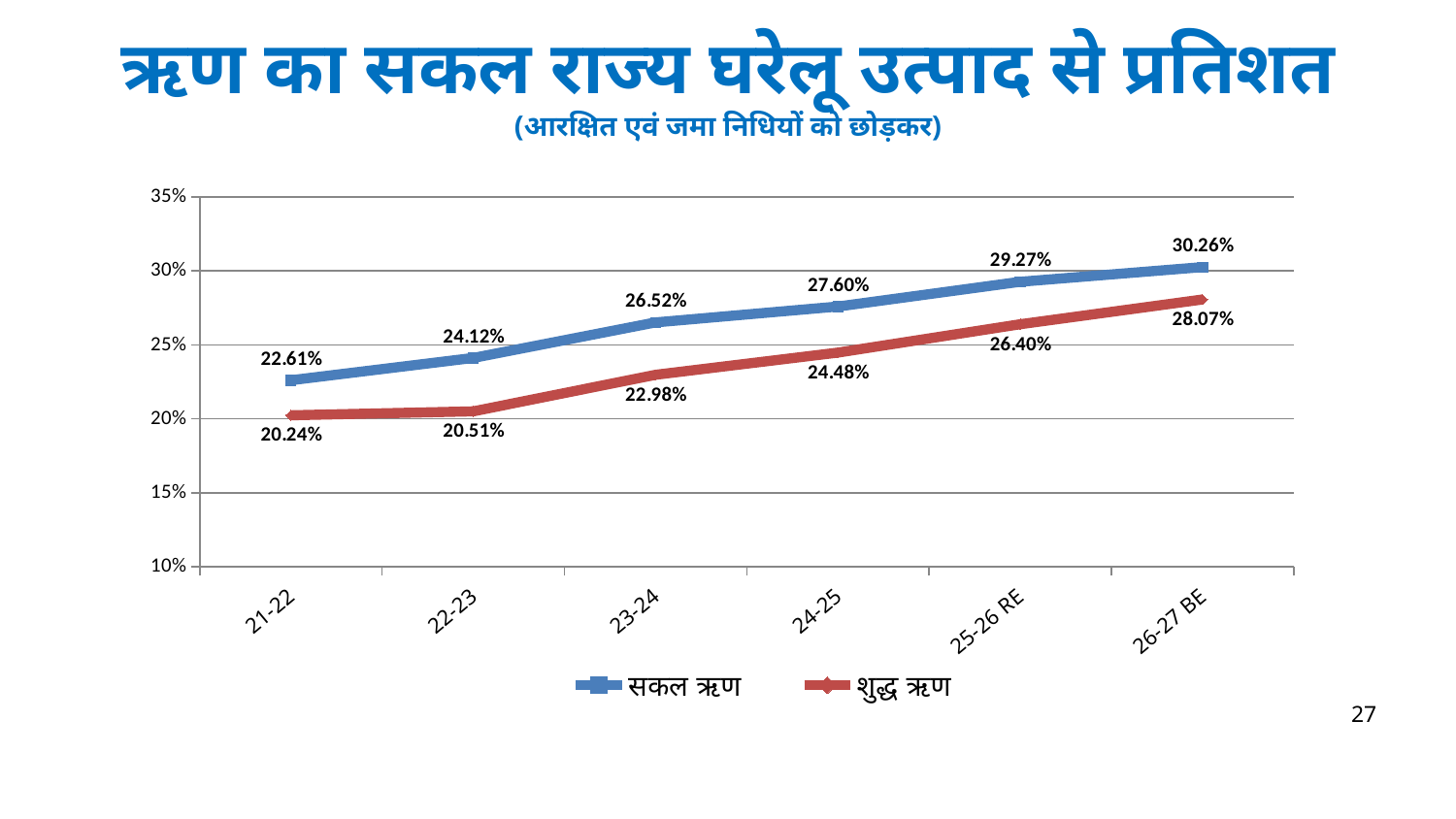
What is the value of सकल ऋण for 26-27 BE? 30.26% How many series does the legend list? 2 What is the value of शुद्ध ऋण for 25-26 RE? 26.40% How many years are shown on the x axis? 6 What is the value of सकल ऋण for 23-24? 26.52% In which year is शुद्ध ऋण lowest? 21-22 Which is larger in 24-25: सकल ऋण or शुद्ध ऋण? सकल ऋण Is the value of शुद्ध ऋण for 22-23 greater or less than 25%? less In which year is सकल ऋण highest? 26-27 BE Does सकल ऋण rise or fall from 21-22 to 26-27 BE? rise What kind of chart is shown on the slide? line chart What is the difference between सकल ऋण and शुद्ध ऋण in 21-22? 2.37%